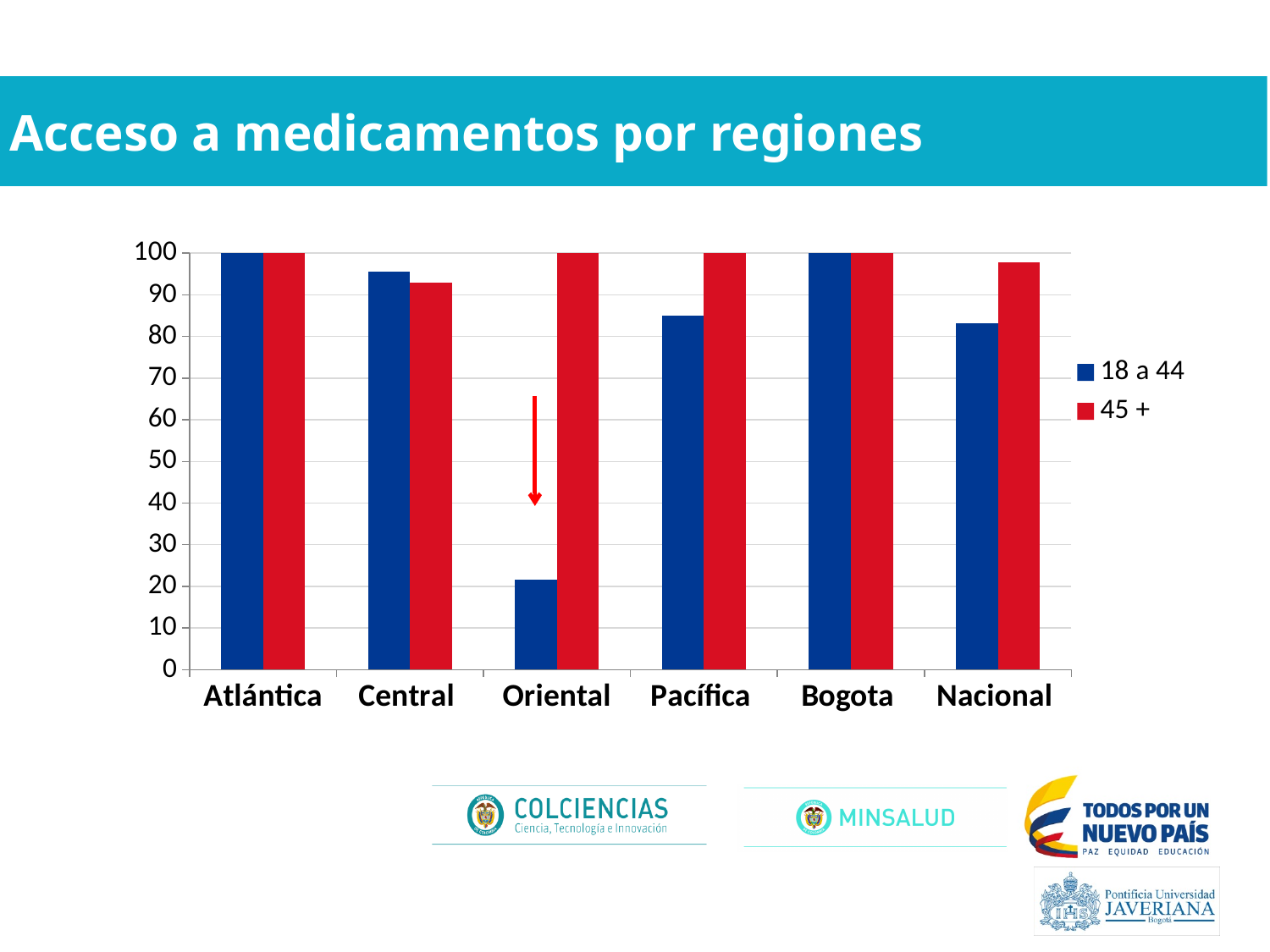
For Oriental, which series has the larger value, 18 a 44 or 45 +? 45 + How many regions are shown on the x axis? 6 Is the value for Oriental in the 18 a 44 series greater or less than 30? less Is the value for Pacífica in the 18 a 44 series greater or less than 90? less What kind of chart is shown on the slide? bar chart What is the title of the slide's chart? Acceso a medicamentos por regiones For Nacional, which series has the larger value, 18 a 44 or 45 +? 45 + Is the value for Nacional in the 18 a 44 series greater or less than 80? greater Which colour represents the 45 + series in the chart? red How many series does the legend list? 2 Which region has the lowest value for the 18 a 44 series? Oriental